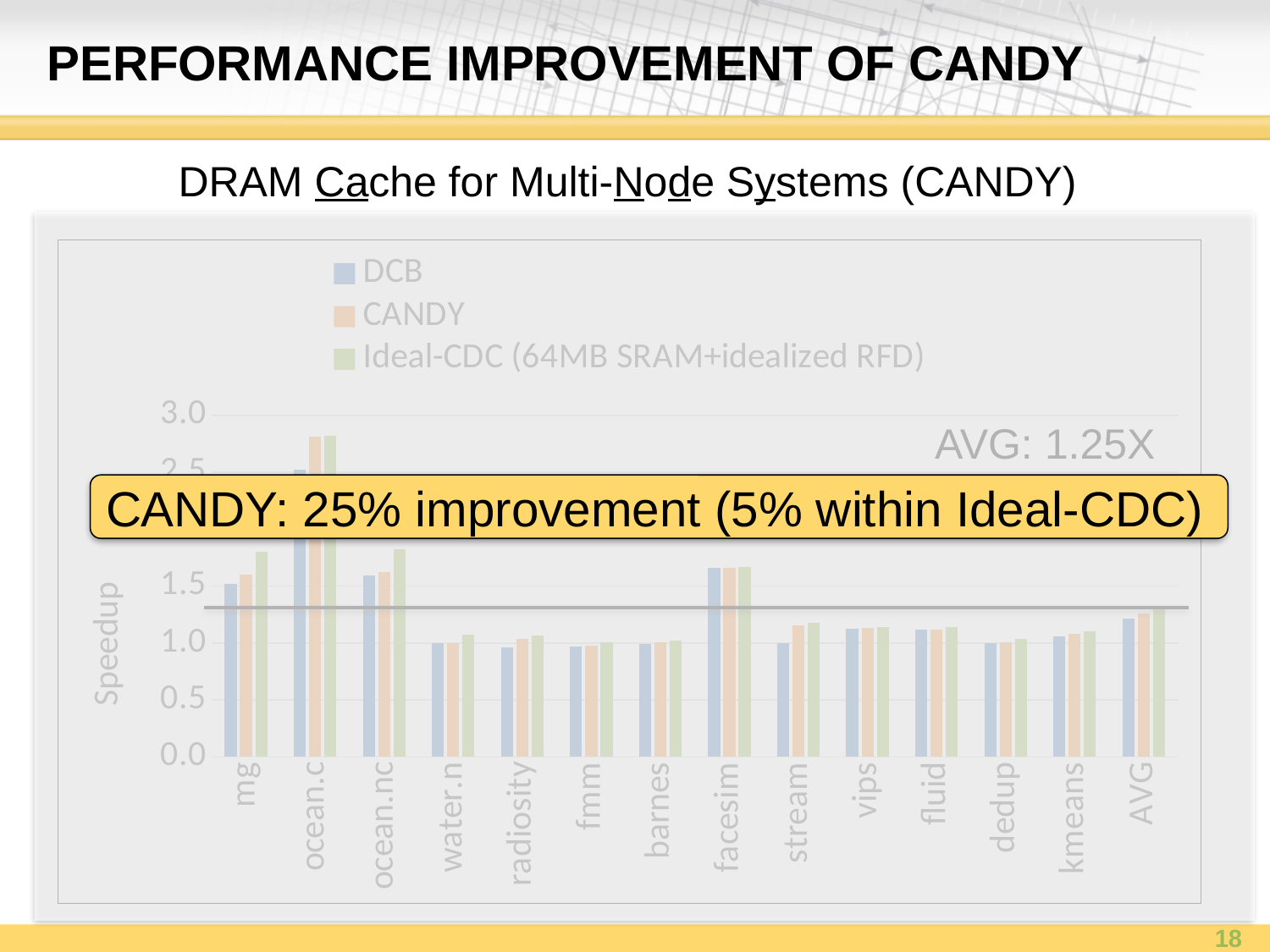
What type of chart is shown on the slide? bar chart Which category has the highest CANDY speedup? ocean.c What average speedup is annotated on the chart? 1.25X Is the CANDY speedup for ocean.c greater or less than 2.5? greater Which has the larger DCB speedup, ocean.c or fmm? ocean.c What is the third entry in the chart legend? Ideal-CDC (64MB SRAM+idealized RFD) How many categories are shown along the x axis of the chart? 14 Is the DCB speedup for water.n greater or less than 1.5? less What is the label of the y axis of the chart? Speedup Is the DCB speedup for mg greater or less than 1.0? greater How many series does the chart legend list? 3